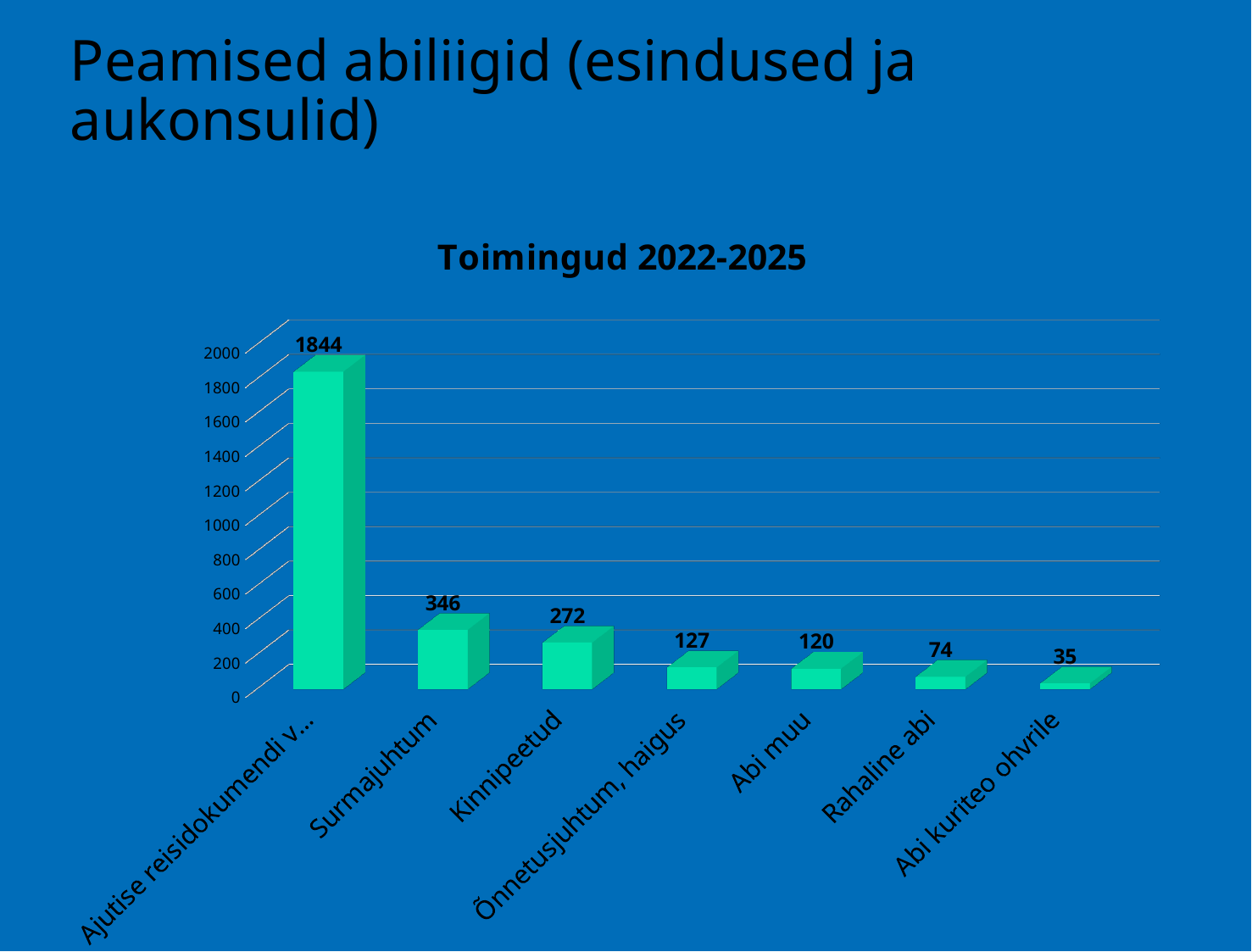
What is the title of the chart? Toimingud 2022-2025 What is the value shown on the leftmost bar of the chart? 1844 What is the value for Surmajuhtum in the Toimingud 2022-2025 chart? 346 What kind of chart is shown on the slide? Bar chart What is the value for Kinnipeetud? 272 Do the values rise or fall from left to right along the x axis? Fall Which category has the lowest value in the chart? Abi kuriteo ohvrile How many categories are shown in the chart? 7 What is the value for Rahaline abi? 74 Which is larger, the value for Rahaline abi or the value for Abi kuriteo ohvrile? Rahaline abi What is the difference between the values for Õnnetusjuhtum, haigus and Abi muu? 7 What is the difference between the values for Surmajuhtum and Kinnipeetud? 74